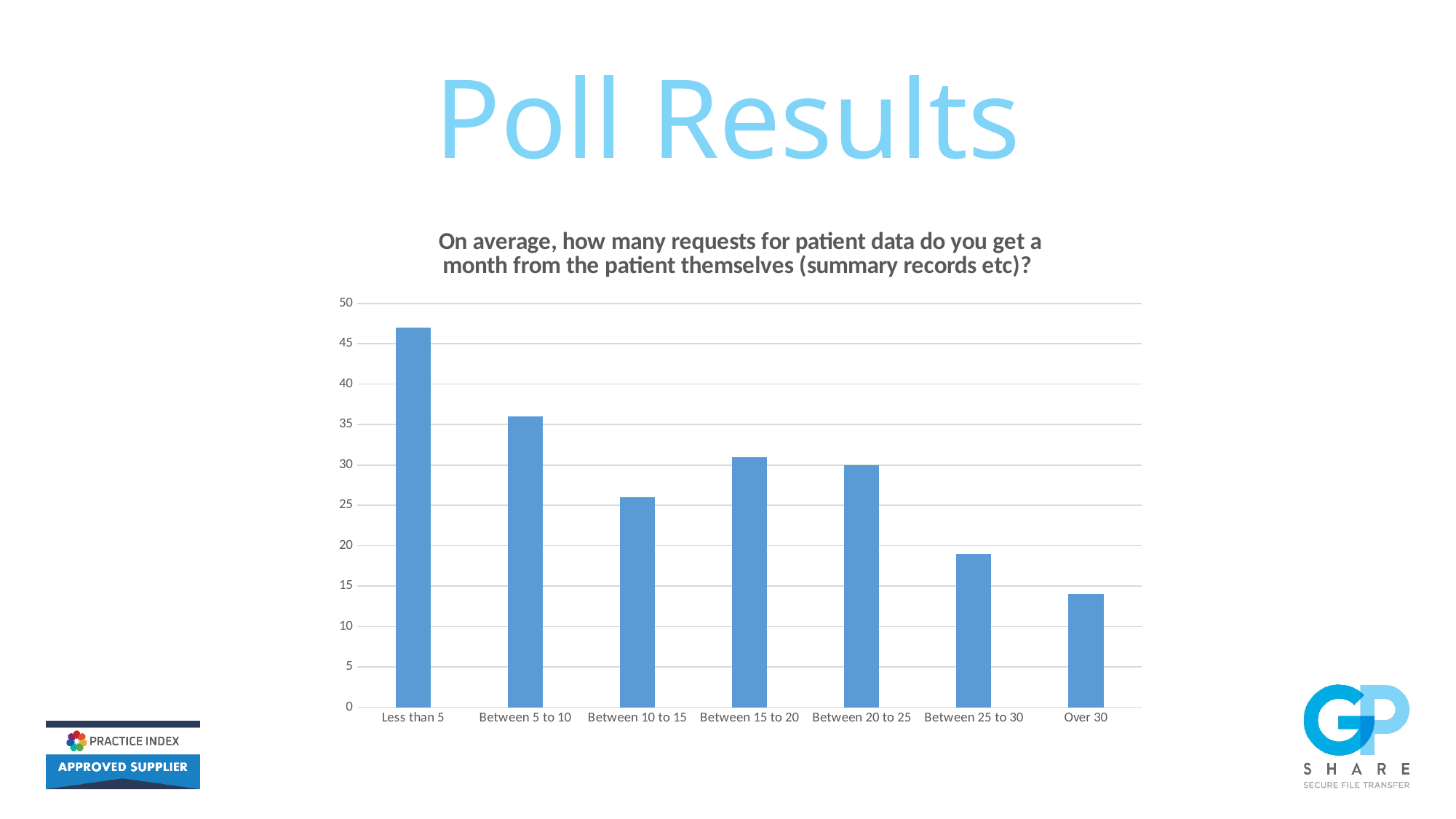
Which category has the lowest value in the chart? Over 30 What kind of chart is shown on the slide? bar chart Is the value for Between 5 to 10 greater or less than 40? less Is the value for Between 10 to 15 greater or less than 25? greater Is the value for Less than 5 greater or less than 45? greater Which category has the highest value in the chart? Less than 5 Which is larger, the value for Between 5 to 10 or the value for Between 10 to 15? Between 5 to 10 What is the title of the chart? On average, how many requests for patient data do you get a month from the patient themselves (summary records etc)? How many categories are shown on the x axis of the chart? 7 Which is larger, the value for Between 15 to 20 or the value for Between 25 to 30? Between 15 to 20